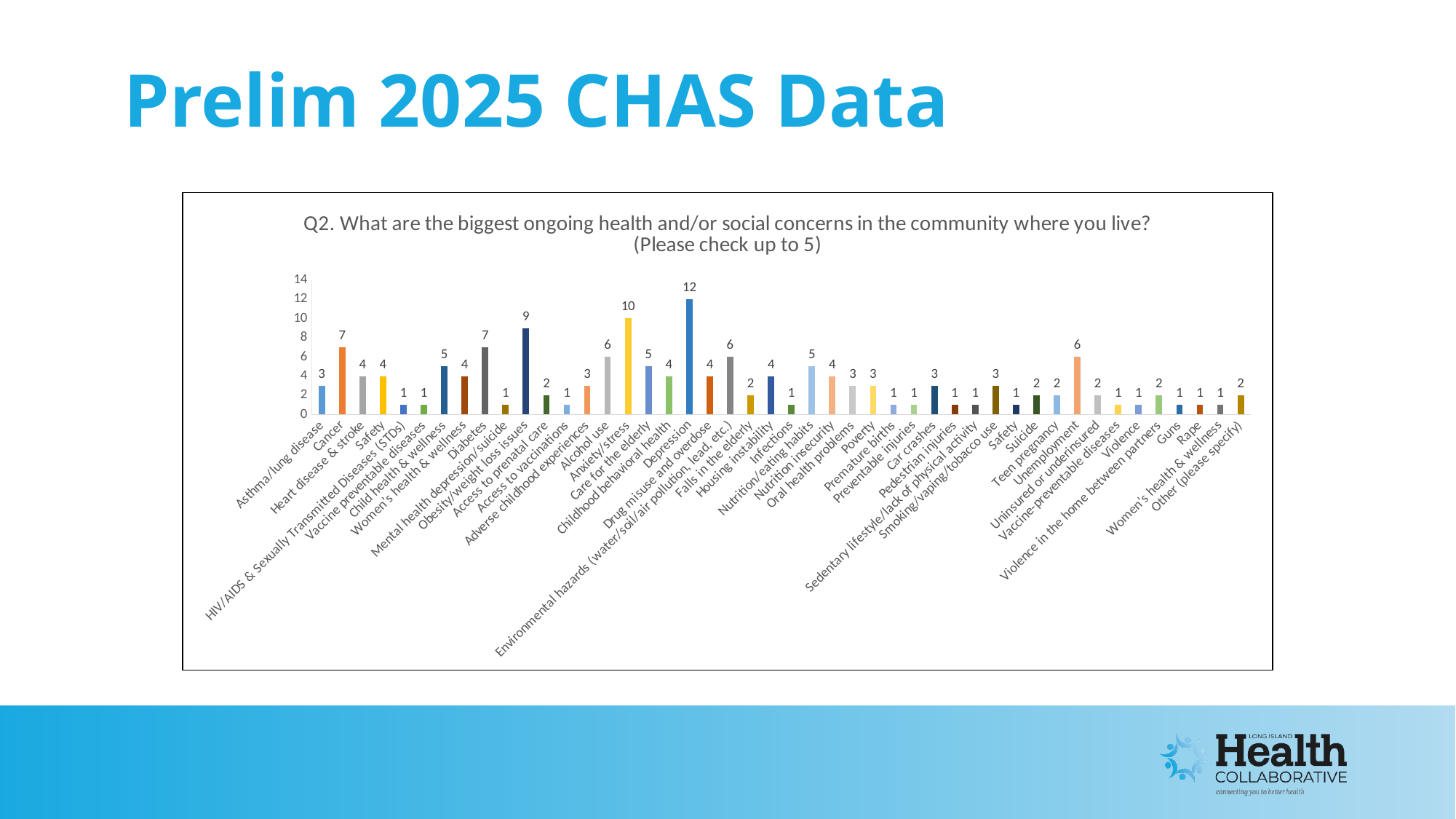
What is the title of the chart? Q2. What are the biggest ongoing health and/or social concerns in the community where you live? (Please check up to 5) What is the difference between the values for Depression and Anxiety/stress? 2 What is the difference between the values for Cancer and Asthma/lung disease? 4 What value is shown for Obesity/weight loss issues? 9 What value is shown for Depression? 12 What kind of chart is shown on the slide? bar chart Is the value for Obesity/weight loss issues greater or less than 8? greater What value is shown for Unemployment? 6 What value is shown for Cancer? 7 Which is larger, the value for Alcohol use or the value for Care for the elderly? Alcohol use What value is shown for Anxiety/stress? 10 Which category has the highest value? Depression